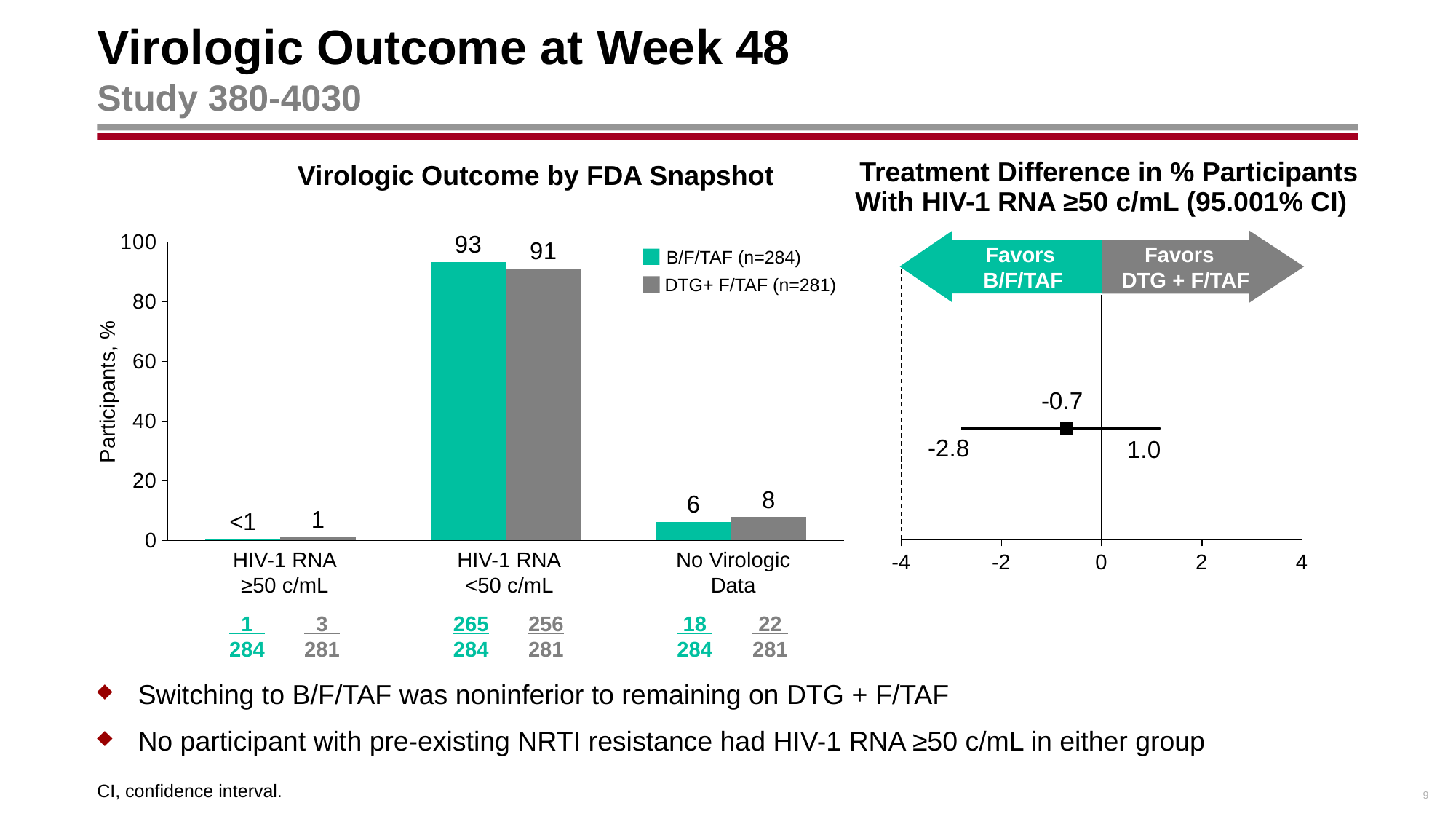
In the 'Virologic Outcome by FDA Snapshot' chart, how many outcome categories are shown on the x axis? 3 In the 'Virologic Outcome by FDA Snapshot' chart, which outcome category has the highest percentage for B/F/TAF? HIV-1 RNA <50 c/mL In the 'Virologic Outcome by FDA Snapshot' chart, what percentage of B/F/TAF participants had HIV-1 RNA <50 c/mL? 93 In the 'Treatment Difference in % Participants With HIV-1 RNA ≥50 c/mL' chart, what is the point estimate of the treatment difference? -0.7 In the 'Virologic Outcome by FDA Snapshot' chart, what percentage of B/F/TAF participants had No Virologic Data? 6 In the 'Virologic Outcome by FDA Snapshot' chart, what percentage of DTG+ F/TAF participants had HIV-1 RNA <50 c/mL? 91 In the 'Virologic Outcome by FDA Snapshot' chart, what percentage of DTG+ F/TAF participants had No Virologic Data? 8 In the 'Virologic Outcome by FDA Snapshot' chart, how many series does the legend list? 2 In the 'Treatment Difference in % Participants With HIV-1 RNA ≥50 c/mL' chart, what are the lower and upper bounds of the confidence interval? -2.8 and 1.0 In the 'Virologic Outcome by FDA Snapshot' chart, which group has the higher percentage with No Virologic Data? DTG+ F/TAF In the 'Virologic Outcome by FDA Snapshot' chart, what is the difference between the B/F/TAF and DTG+ F/TAF percentages for HIV-1 RNA <50 c/mL? 2 What kind of chart is 'Virologic Outcome by FDA Snapshot'? Bar chart